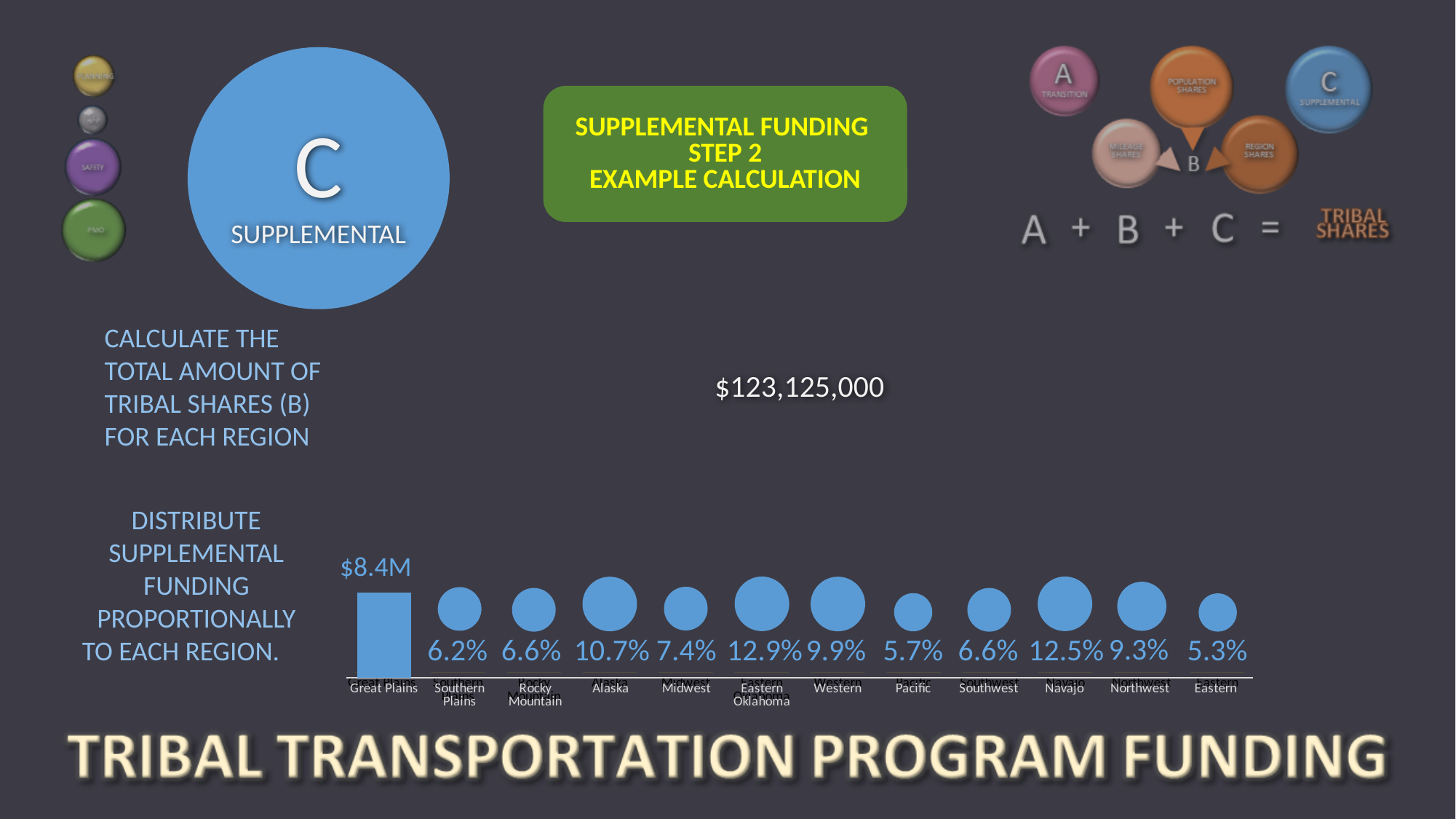
Which region has the lowest percentage shown in the chart? Eastern Which has the larger percentage in the chart, Alaska or Midwest? Alaska How many regions are shown along the x axis of the chart? 12 Which region has the highest percentage shown in the chart? Eastern Oklahoma What is the difference in percentage points between Eastern Oklahoma and Eastern in the chart? 7.6 Which has the larger percentage in the chart, Navajo or Eastern Oklahoma? Eastern Oklahoma What percentage is shown for Alaska in the chart? 10.7% What percentage is shown for Eastern Oklahoma in the chart? 12.9% What is the difference in percentage points between Western and Northwest in the chart? 0.6 What value is labelled on the Great Plains bar in the chart? $8.4M What total dollar amount is printed above the chart on the slide? $123,125,000 What percentage is shown for Navajo in the chart? 12.5%